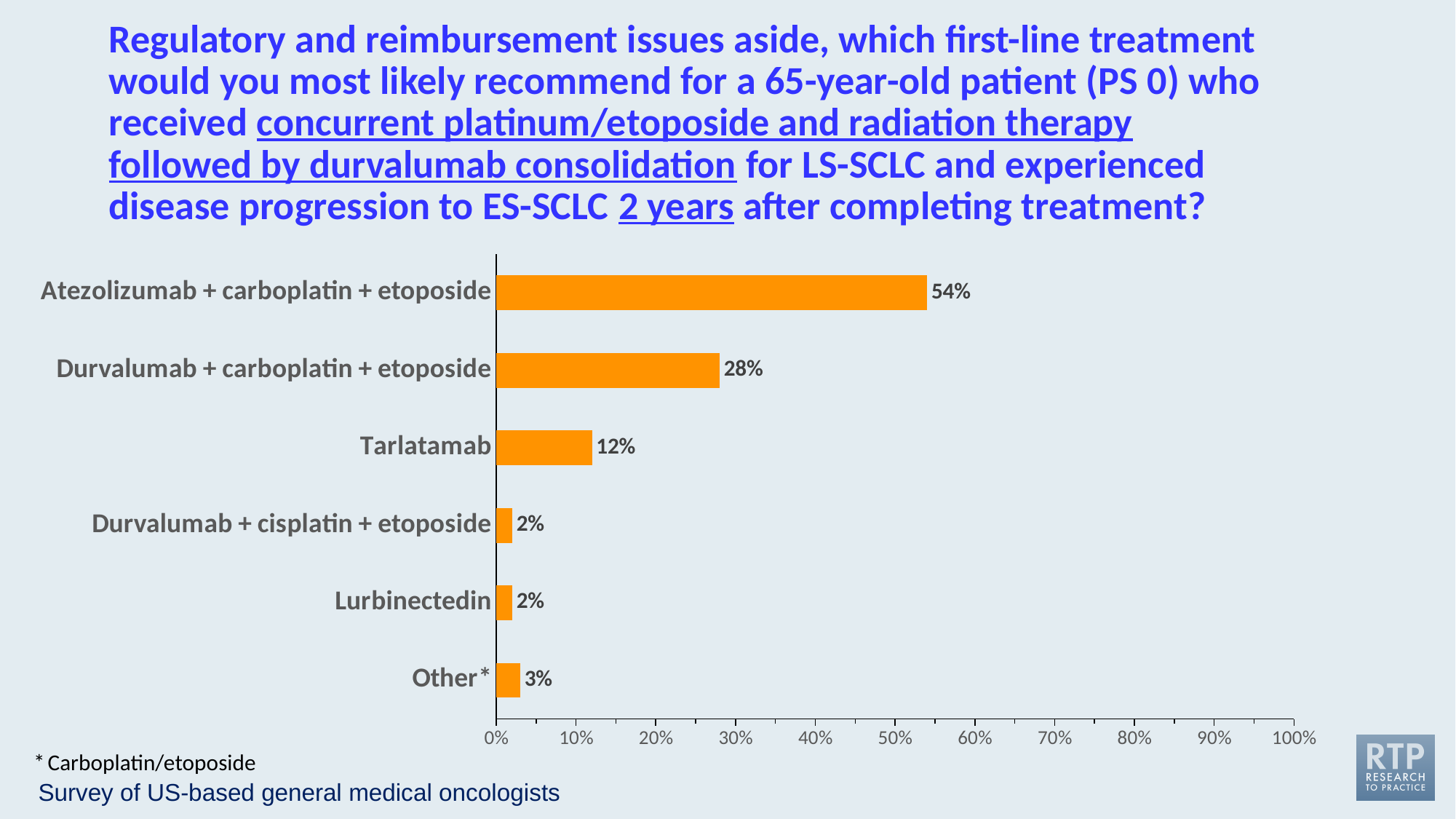
What is the combined percentage for Durvalumab + cisplatin + etoposide and Lurbinectedin? 4% Is the value for Durvalumab + carboplatin + etoposide greater or less than 30%? less What percentage of respondents chose Other*? 3% What percentage of respondents chose Atezolizumab + carboplatin + etoposide? 54% What is the difference in percentage points between Atezolizumab + carboplatin + etoposide and Durvalumab + carboplatin + etoposide? 26 How many treatment options are shown in the chart? 6 What percentage of respondents chose Tarlatamab? 12% What does the asterisk next to 'Other' refer to, according to the footnote? Carboplatin/etoposide Which treatment option received the highest percentage of responses? Atezolizumab + carboplatin + etoposide What type of chart is shown on the slide? Bar chart Which received a larger share of responses, Tarlatamab or Durvalumab + cisplatin + etoposide? Tarlatamab What percentage of respondents chose Durvalumab + carboplatin + etoposide? 28%